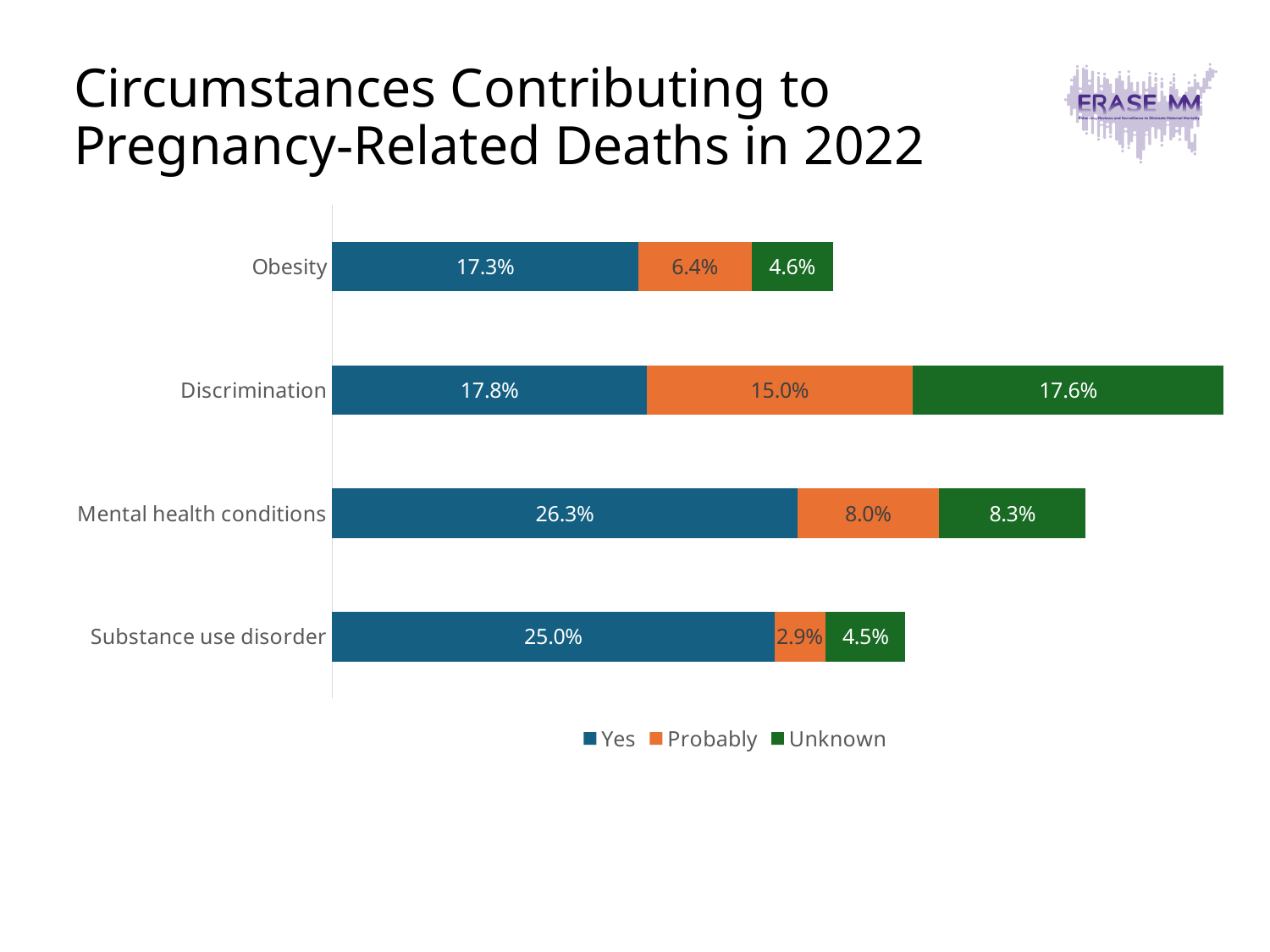
What is the 'Unknown' value for Substance use disorder? 4.5% How many series does the legend list? 3 Which is larger, the 'Unknown' value for Discrimination or the 'Unknown' value for Mental health conditions? Discrimination What is the 'Probably' value for Discrimination? 15.0% What is the difference between the 'Yes' values for Mental health conditions and Obesity? 9.0% What is the total of the stacked bar for Discrimination? 50.4% What kind of chart is shown on the slide? Stacked bar chart What is the total of the stacked bar for Obesity? 28.3% Which category has the lowest 'Probably' value? Substance use disorder How many categories are shown on the chart? 4 Which category has the highest 'Yes' value? Mental health conditions What is the 'Yes' value for Mental health conditions? 26.3%